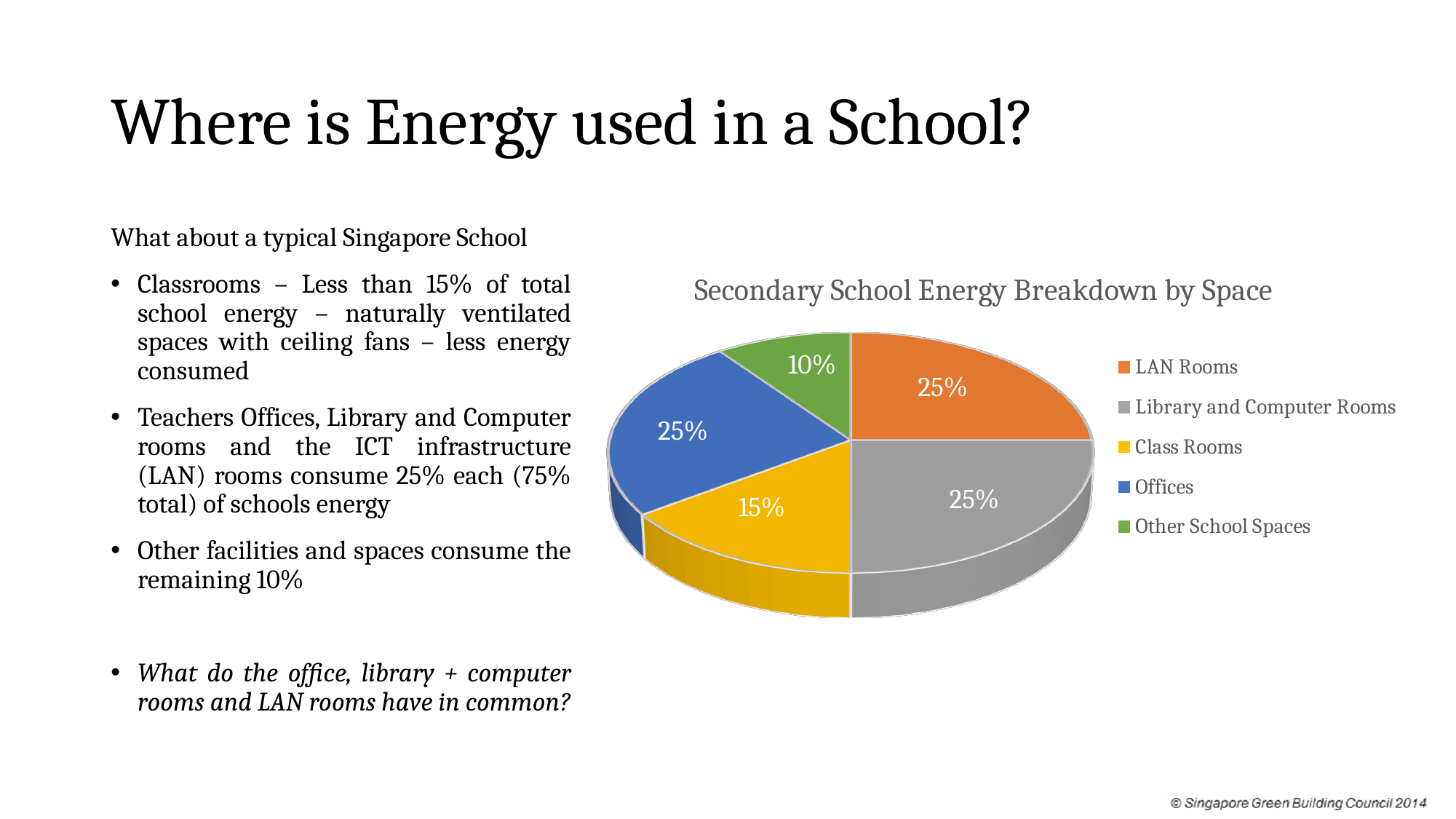
What share of energy do Class Rooms account for? 15% Which category has the smallest share of the pie? Other School Spaces How many categories does the pie chart show? 5 What share of energy do LAN Rooms account for? 25% What colour is the Offices slice? Blue What share of energy do Other School Spaces account for? 10% Which is larger, the share for Library and Computer Rooms or the share for Class Rooms? Library and Computer Rooms What is the combined share of LAN Rooms, Library and Computer Rooms, and Offices? 75% What is the difference between the share for Class Rooms and the share for Other School Spaces? 5% What type of chart is shown on the slide? Pie chart What share of energy do Offices account for? 25% What is the title of the chart? Secondary School Energy Breakdown by Space